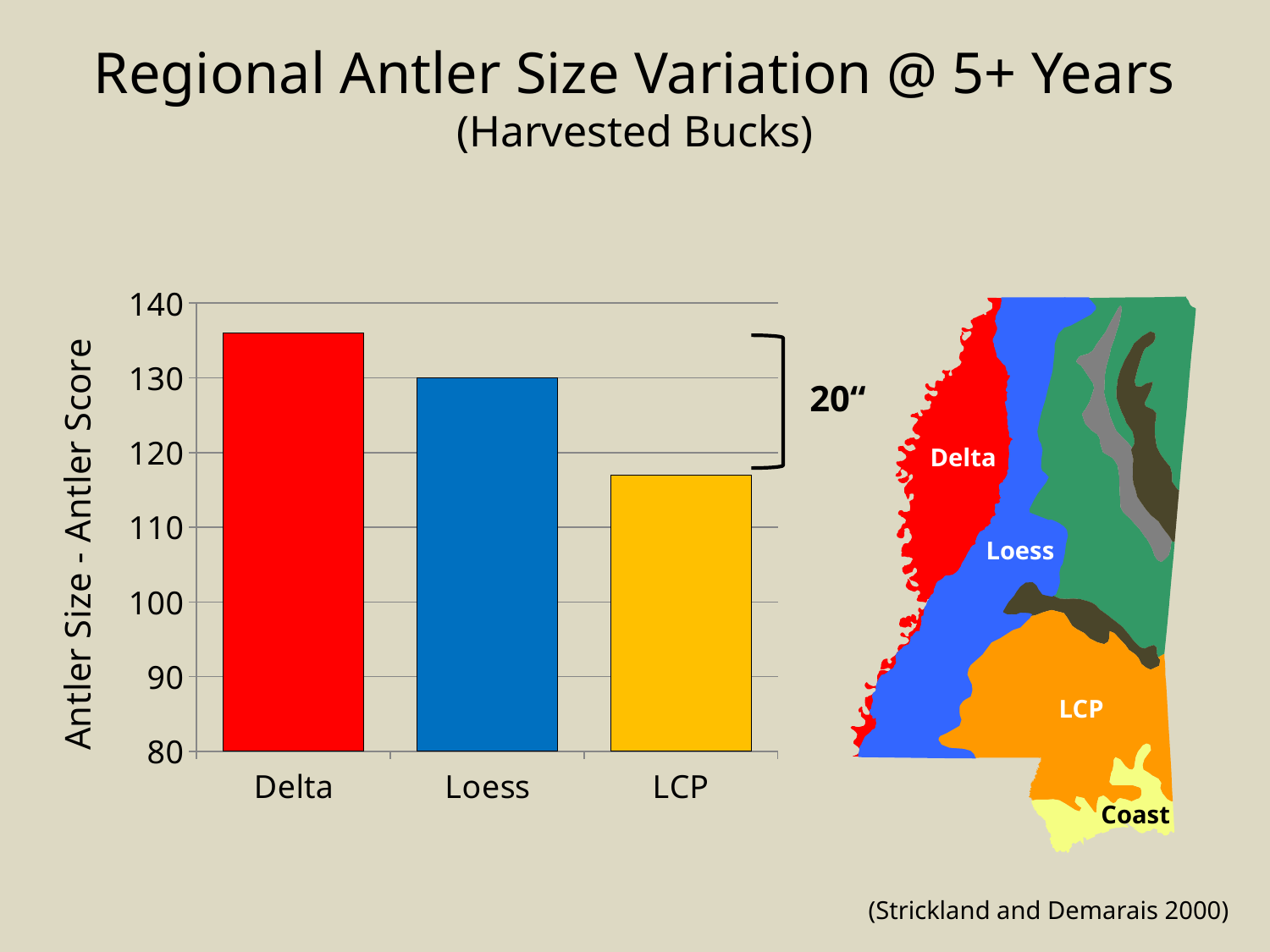
Is the antler score for LCP greater or less than 120? less Is the antler score for LCP greater or less than 110? greater Do the antler scores rise or fall moving from Delta to LCP along the x axis? fall Which region has the highest antler score? Delta Which region has the lowest antler score? LCP What colour is the bar for Loess? blue What type of chart is shown on the slide? bar chart What is the label of the y axis? Antler Size - Antler Score Is the antler score for Delta greater or less than 140? less Which region has a larger antler score, Loess or LCP? Loess How many regions are plotted on the chart? 3